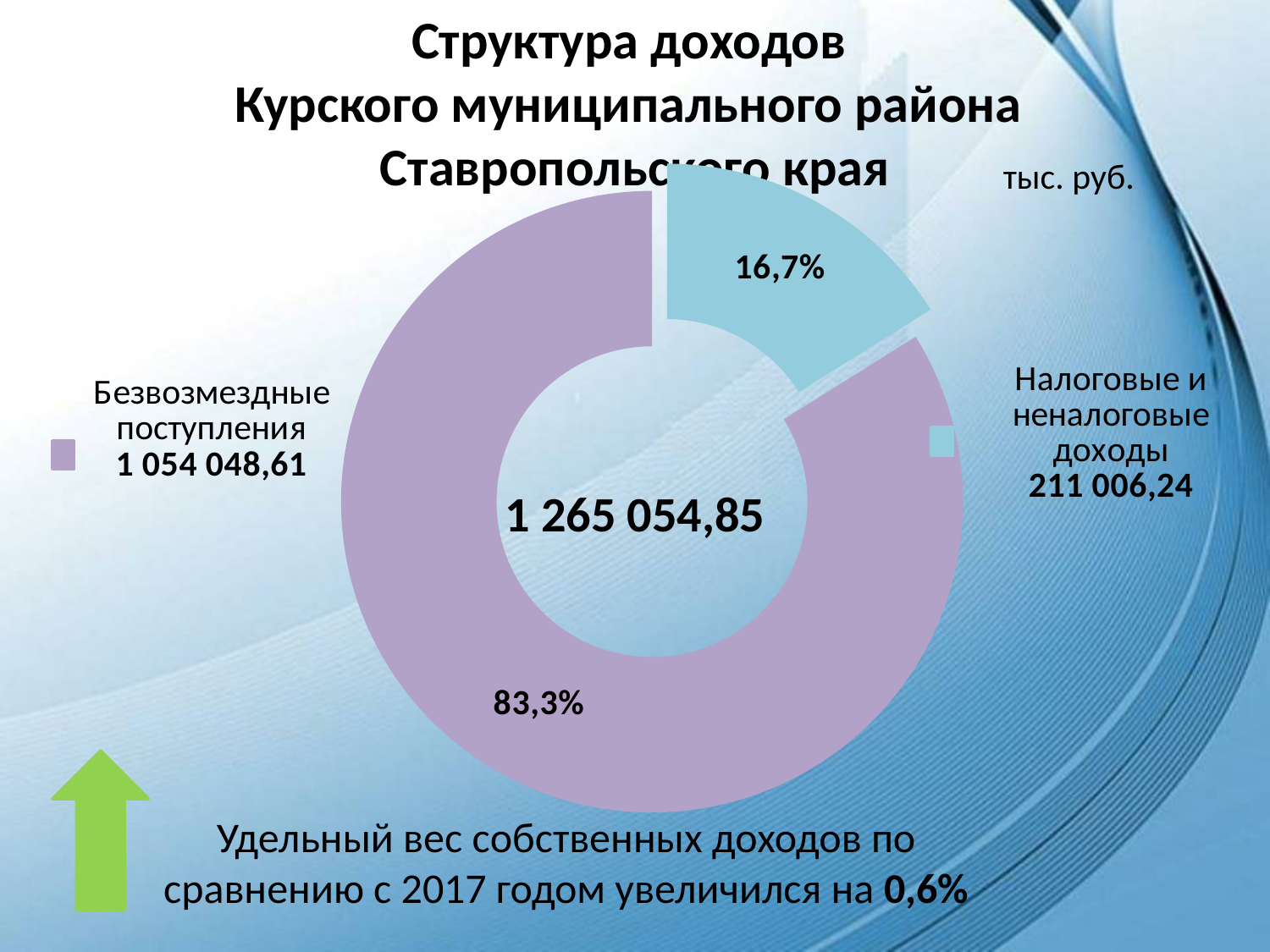
What is the difference between the values for Безвозмездные поступления and Налоговые и неналоговые доходы? 843 042,37 In what units are the chart values given? тыс. руб. What is the value for Налоговые и неналоговые доходы? 211 006,24 What kind of chart is shown on the slide? Pie (donut) chart Which is larger: Безвозмездные поступления or Налоговые и неналоговые доходы? Безвозмездные поступления How many categories does the chart show? 2 Which category has the smallest value? Налоговые и неналоговые доходы Which category has the largest value? Безвозмездные поступления What share of the chart does Налоговые и неналоговые доходы take? 16,7% What share of the chart does Безвозмездные поступления take? 83,3% What is the value for Безвозмездные поступления? 1 054 048,61 What total value is printed in the centre of the chart? 1 265 054,85